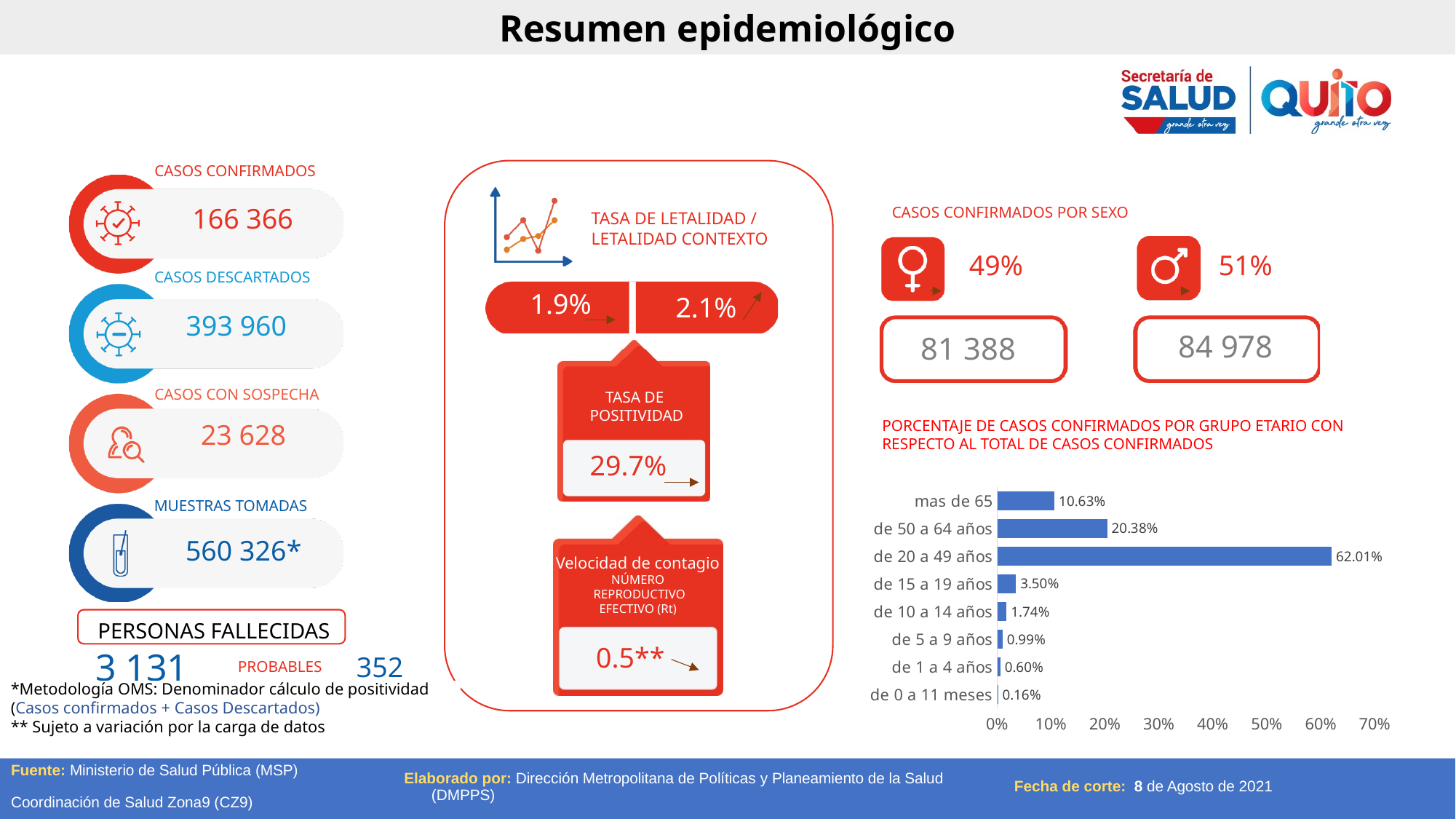
In the bar chart of confirmed cases by age group, what is the value for 'de 20 a 49 años'? 62.01% In the bar chart of confirmed cases by age group, what is the value for 'de 50 a 64 años'? 20.38% In the bar chart of confirmed cases by age group, is the value for 'de 50 a 64 años' greater or less than 30%? less In the bar chart of confirmed cases by age group, what is the difference between 'de 20 a 49 años' and 'de 50 a 64 años'? 41.63% What is the highest value shown on the x axis of the bar chart of confirmed cases by age group? 70% In the bar chart of confirmed cases by age group, which is larger: 'de 15 a 19 años' or 'de 10 a 14 años'? de 15 a 19 años What type of chart is used to show the percentage of confirmed cases by age group? bar chart How many age groups are shown in the bar chart of confirmed cases by age group? 8 In the bar chart of confirmed cases by age group, which age group has the highest percentage? de 20 a 49 años In the bar chart of confirmed cases by age group, which age group has the lowest percentage? de 0 a 11 meses In the bar chart of confirmed cases by age group, what is the value for 'de 0 a 11 meses'? 0.16% In the bar chart of confirmed cases by age group, what is the value for 'mas de 65'? 10.63%